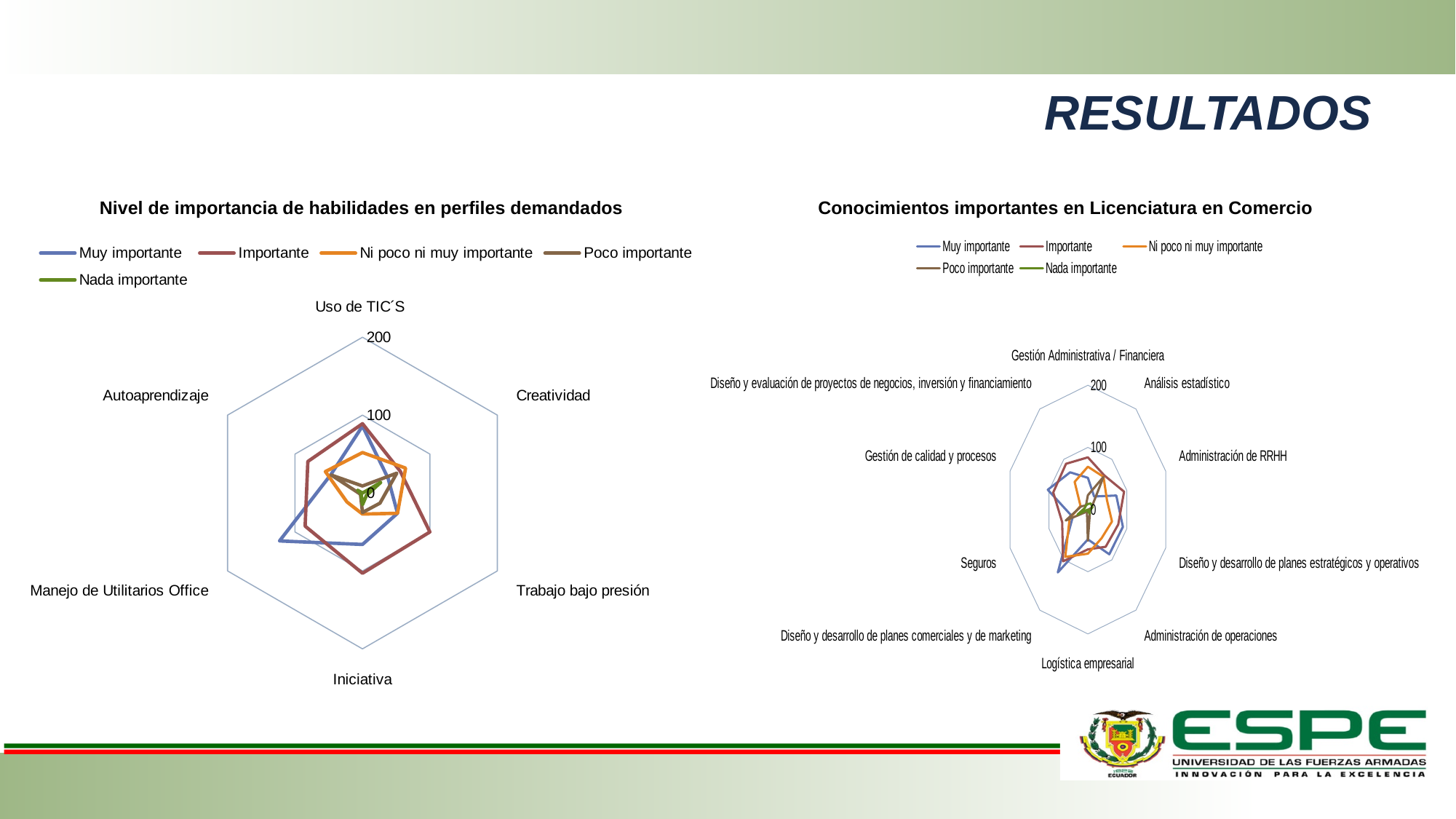
What kind of chart is 'Conocimientos importantes en Licenciatura en Comercio'? Radar chart In the chart 'Nivel de importancia de habilidades en perfiles demandados', how many skill categories are plotted around the radar? 6 In the chart 'Nivel de importancia de habilidades en perfiles demandados', is the value of 'Muy importante' for 'Manejo de Utilitarios Office' greater or less than 100? greater In the chart 'Nivel de importancia de habilidades en perfiles demandados', is the value of 'Ni poco ni muy importante' for 'Uso de TIC´S' greater or less than 100? less In the chart 'Conocimientos importantes en Licenciatura en Comercio', how many knowledge categories are plotted around the radar? 10 How many series does the legend of 'Nivel de importancia de habilidades en perfiles demandados' list? 5 What kind of chart is 'Nivel de importancia de habilidades en perfiles demandados'? Radar chart In the chart 'Nivel de importancia de habilidades en perfiles demandados', is the value of 'Importante' for 'Iniciativa' greater or less than 200? less In the chart 'Nivel de importancia de habilidades en perfiles demandados', which series is drawn in green? Nada importante What is the title of the chart on the left side of the slide? Nivel de importancia de habilidades en perfiles demandados How many series does the legend of 'Conocimientos importantes en Licenciatura en Comercio' list? 5